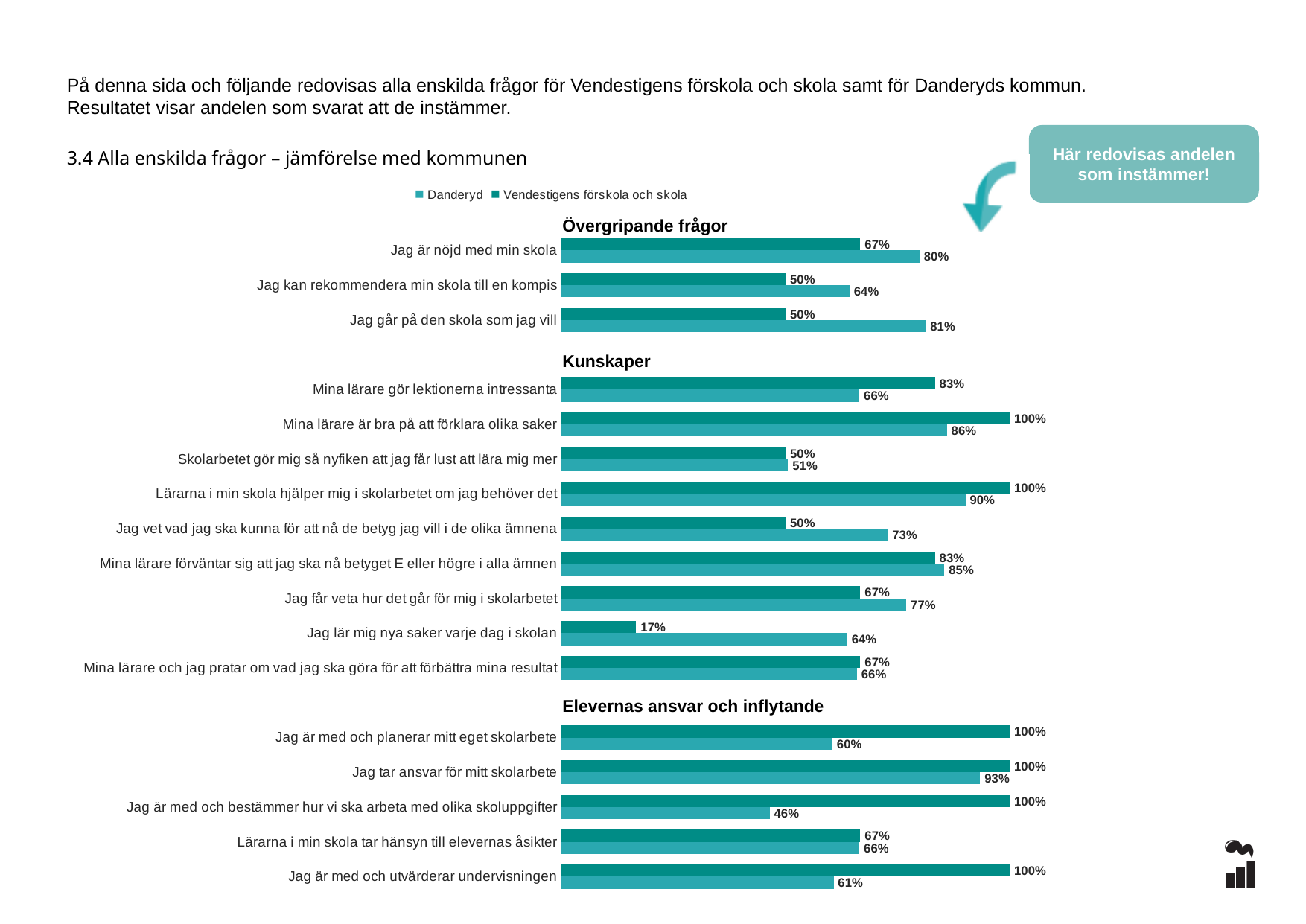
What is the value for Vendestigens förskola och skola for "Jag är nöjd med min skola"? 67% What is the difference between Vendestigens förskola och skola and Danderyd for "Jag är med och planerar mitt eget skolarbete"? 40 percentage points Which question has the highest value for Danderyd? Jag tar ansvar för mitt skolarbete What is the value for Danderyd for "Jag går på den skola som jag vill"? 81% Which question has the lowest value for Vendestigens förskola och skola? Jag lär mig nya saker varje dag i skolan How many series does the legend list? 2 How many questions (categories) are plotted in the chart? 17 What kind of chart is shown on the slide? Bar chart What is the value for Danderyd for "Jag är med och bestämmer hur vi ska arbeta med olika skoluppgifter"? 46% What is the value for Vendestigens förskola och skola for "Jag lär mig nya saker varje dag i skolan"? 17% Which section heading appears above the first group of questions in the chart? Övergripande frågor For "Jag vet vad jag ska kunna för att nå de betyg jag vill i de olika ämnena", which is larger: Danderyd or Vendestigens förskola och skola? Danderyd